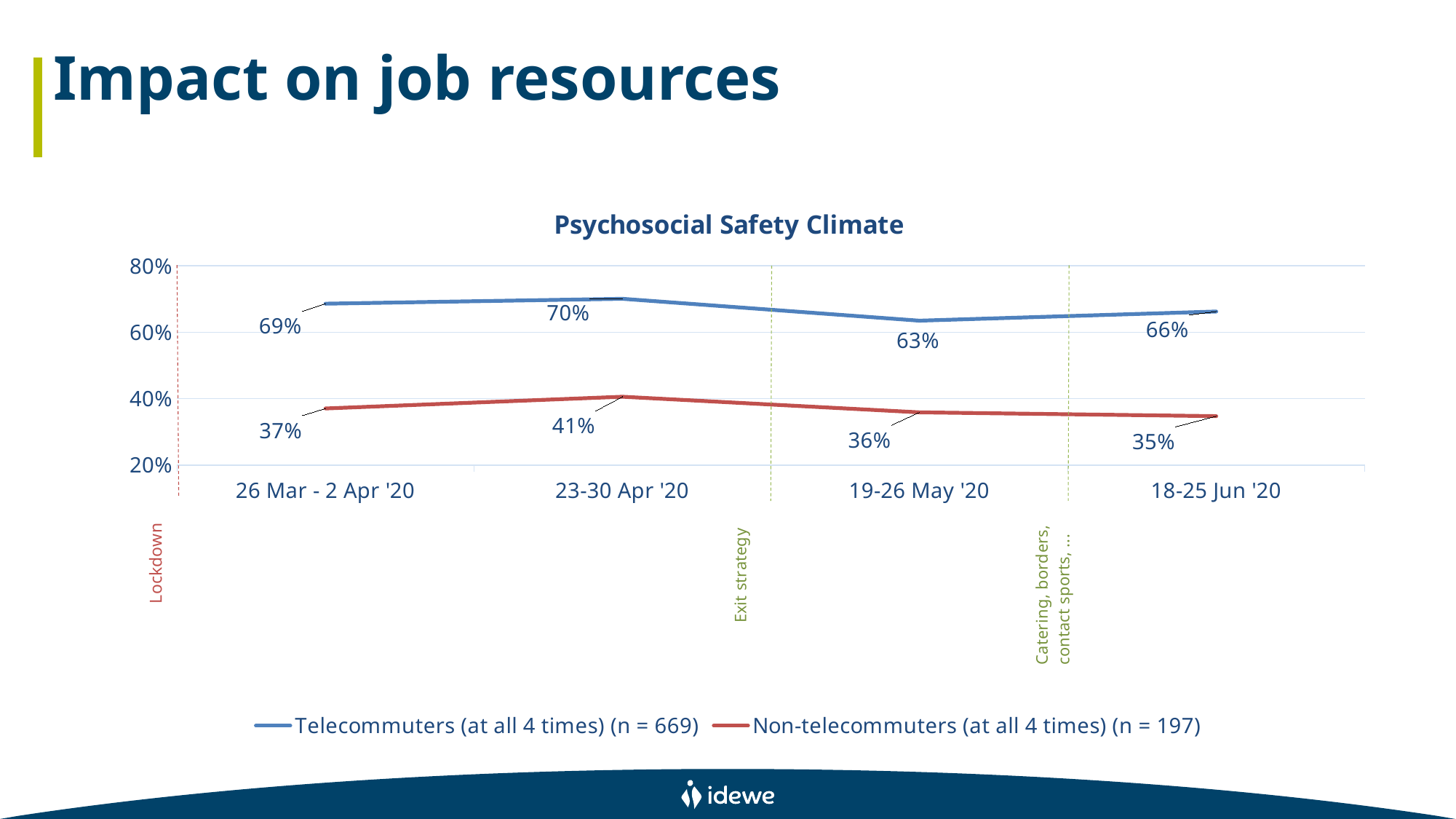
What is the value for Telecommuters in the 19-26 May '20 period? 63% What is the difference between the Telecommuters and Non-telecommuters values in the 26 Mar - 2 Apr '20 period? 32% How many series does the legend list? 2 Does the Non-telecommuters value rise or fall from 23-30 Apr '20 to 18-25 Jun '20? Fall What is the title of the chart? Psychosocial Safety Climate What is the value for Non-telecommuters in the 18-25 Jun '20 period? 35% What kind of chart is shown on the slide? Line chart Which series has the larger value in the 18-25 Jun '20 period, Telecommuters or Non-telecommuters? Telecommuters How many time periods are shown on the x axis? 4 In which period is the Non-telecommuters value highest? 23-30 Apr '20 What is the value for Telecommuters in the 23-30 Apr '20 period? 70% In which period is the Telecommuters value lowest? 19-26 May '20